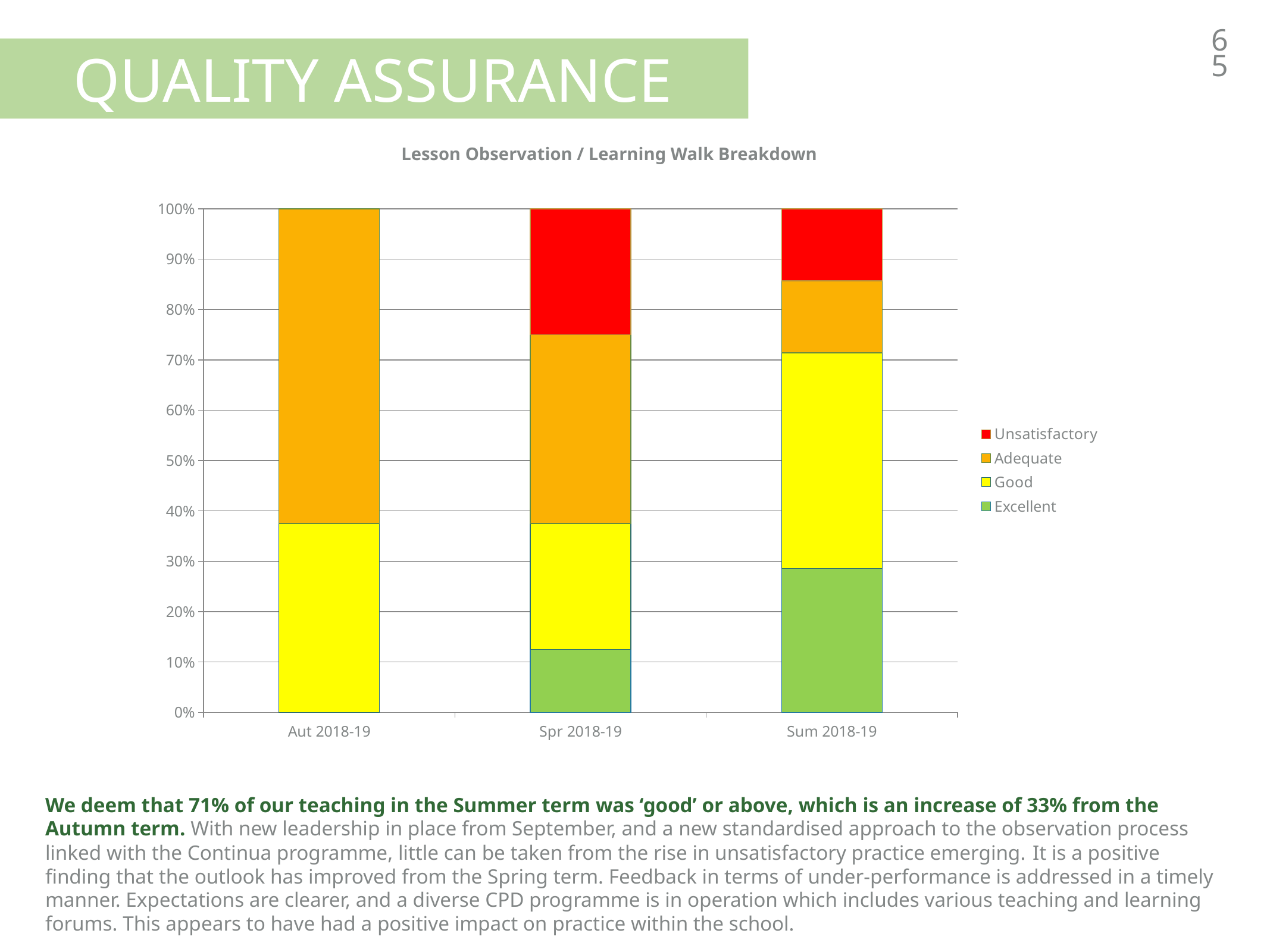
What is the title of the chart? Lesson Observation / Learning Walk Breakdown Is the Unsatisfactory share for Sum 2018-19 greater or less than 20%? less Which term has the largest Adequate share? Aut 2018-19 Which colour represents the Unsatisfactory series in the chart? Red Which term has the largest Excellent share? Sum 2018-19 Is the Adequate share for Aut 2018-19 greater or less than 50%? greater How many series does the chart legend list? 4 Is the Excellent share for Spr 2018-19 greater or less than 20%? less How many terms (categories) are shown on the x axis of the chart? 3 Which term has the larger Unsatisfactory share, Spr 2018-19 or Sum 2018-19? Spr 2018-19 What kind of chart is shown on the slide? Stacked bar chart